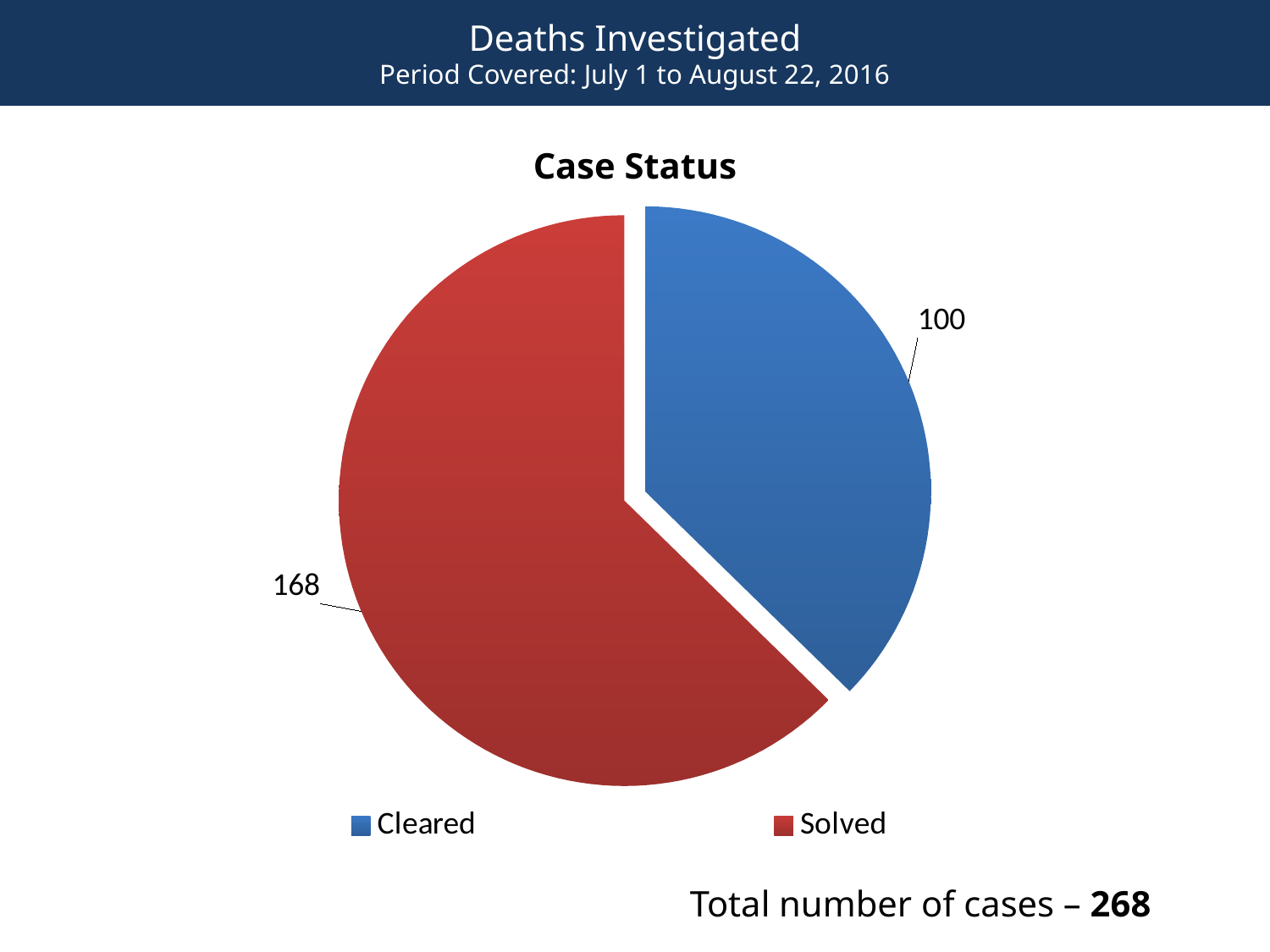
Which is larger in the Case Status chart, Cleared or Solved? Solved What kind of chart is used to show Case Status? Pie chart How many categories are shown in the Case Status pie chart? 2 What is the total of the two slices in the Case Status pie chart? 268 What share of the Case Status pie does the Solved slice represent? 62.7% What is the difference between the Solved and Cleared values in the Case Status chart? 68 What is the title of the pie chart on the slide? Case Status What is the value for Cleared in the Case Status pie chart? 100 What colour is the Cleared slice in the Case Status pie chart? Blue Which category has the largest slice in the Case Status pie chart? Solved What is the value for Solved in the Case Status pie chart? 168 Which category has the smallest slice in the Case Status pie chart? Cleared